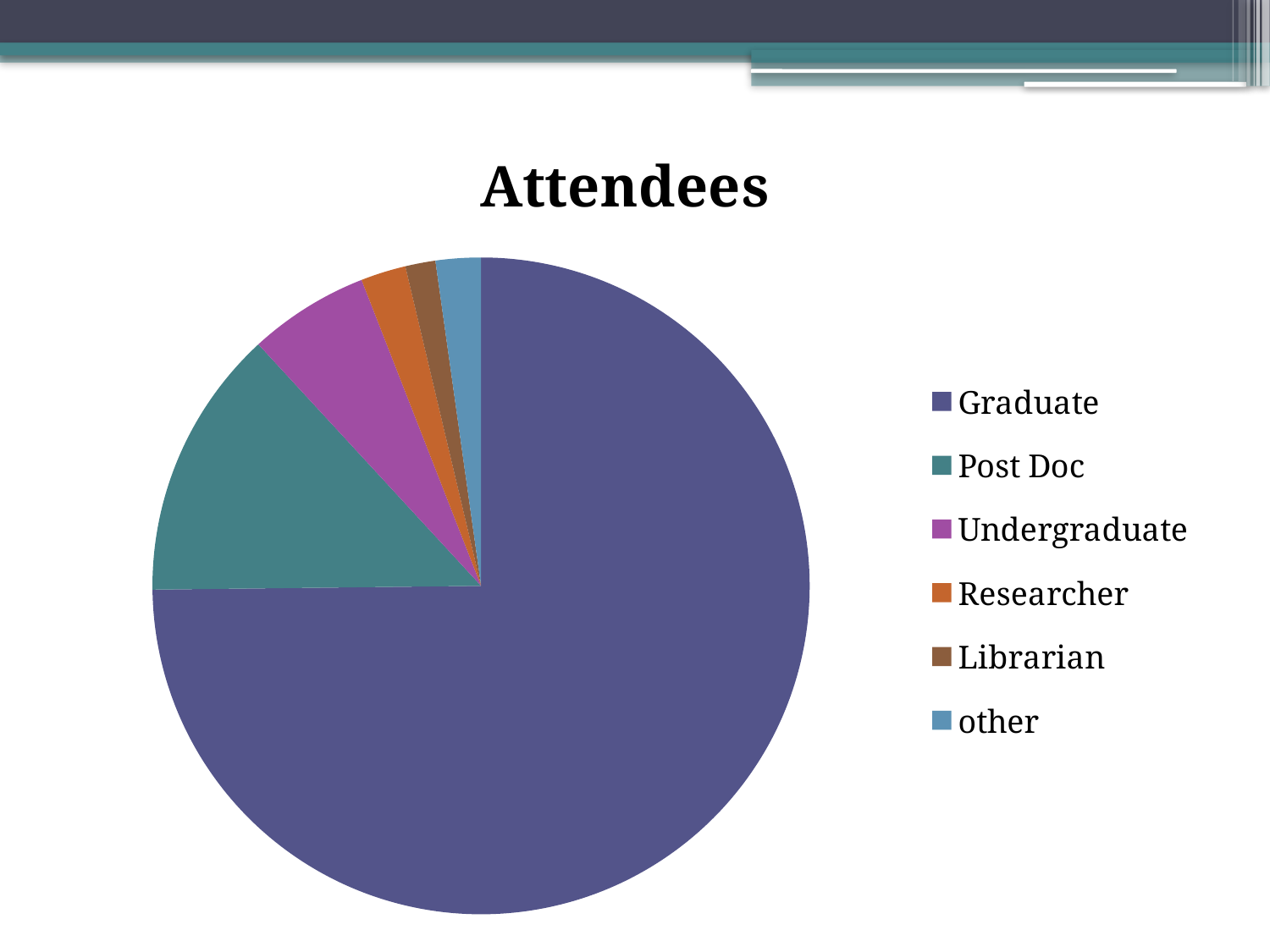
Which slice is larger, Post Doc or Undergraduate? Post Doc Which slice is larger, Graduate or Post Doc? Graduate How many entries does the legend list? 6 Which category has the largest slice of the pie? Graduate What kind of chart is shown on the slide? Pie chart What is the title of the chart? Attendees Which slice is larger, Undergraduate or Researcher? Undergraduate Which category has the smallest slice of the pie? Librarian Is the Graduate slice greater or less than half of the pie? greater How many categories does the pie chart show? 6 What colour is the Undergraduate slice? Purple Which category has the second-largest slice of the pie? Post Doc